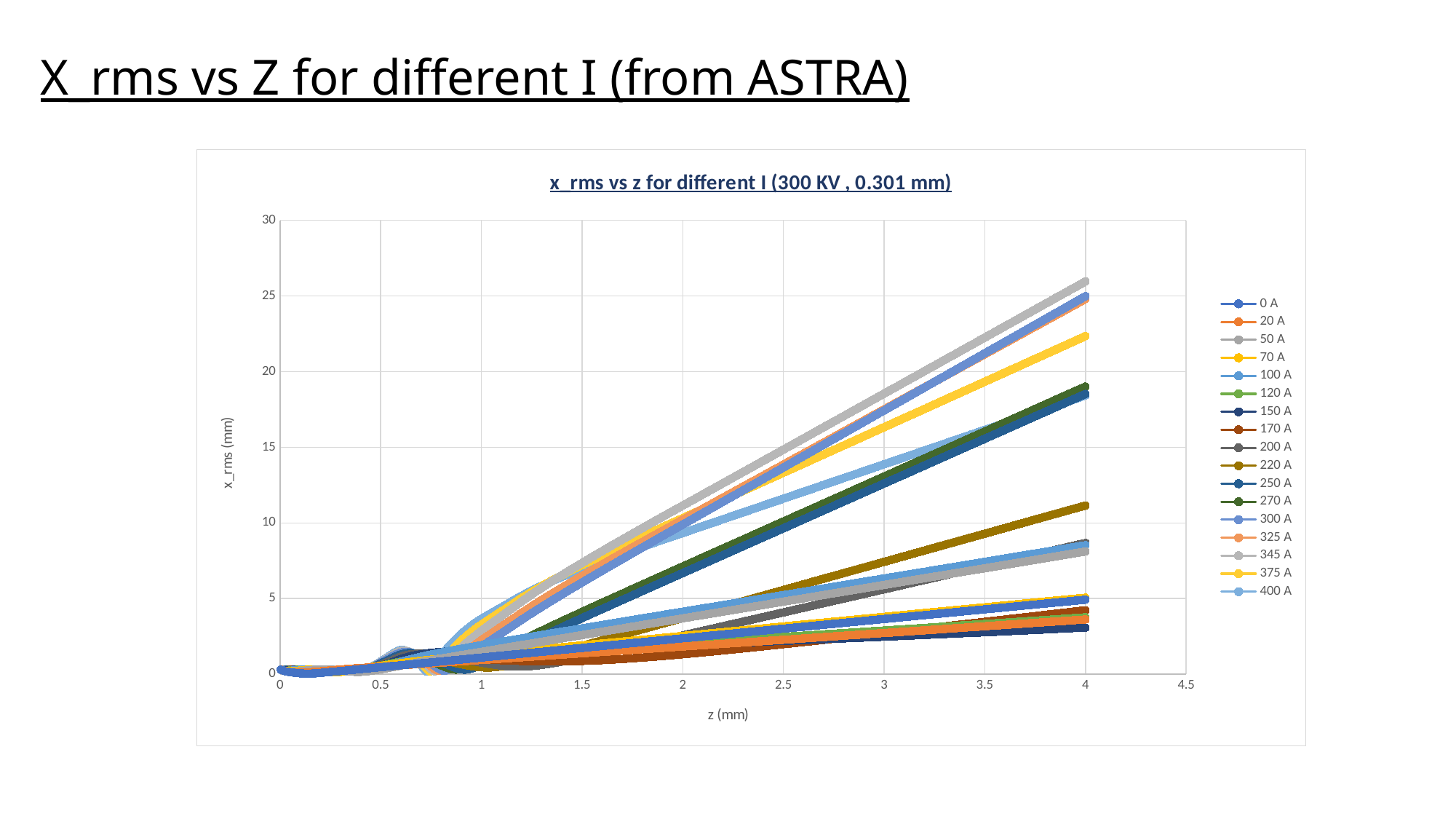
What is the title of the chart? x_rms vs z for different I (300 KV , 0.301 mm) What is the first series listed in the legend? 0 A What is the highest tick value shown on the y axis? 30 Is the highest x_rms value reached by any series at z = 4 mm greater or less than 25? greater Is the highest x_rms value reached by any series at z = 2 mm greater or less than 15? less What kind of chart is shown on the slide? Line chart Do the x_rms values generally rise or fall as z increases from 1 to 4 mm? Rise How many series does the legend list? 17 Is the lowest x_rms value among the series at z = 4 mm greater or less than 5? less